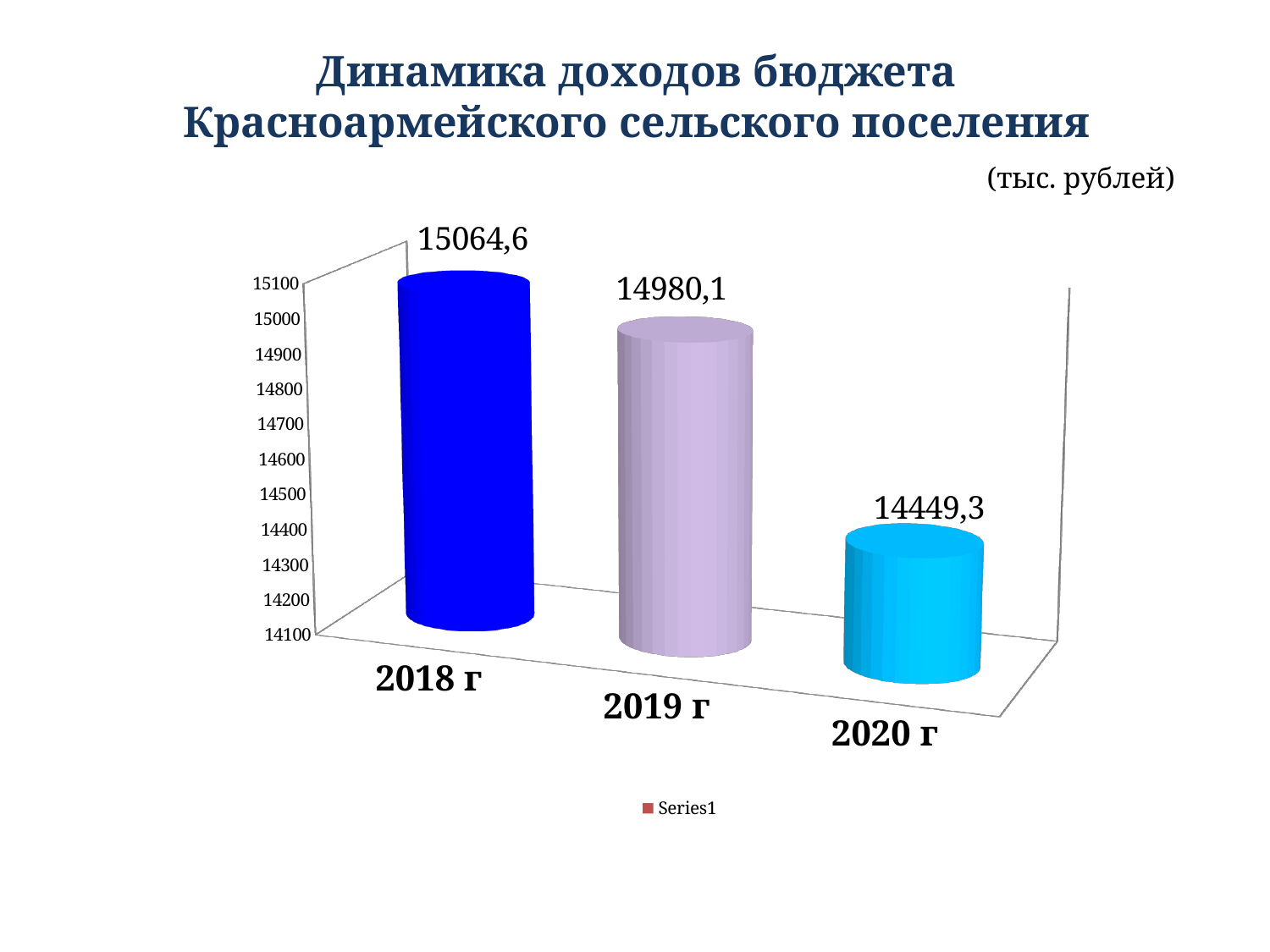
How many series does the legend list? 1 Which year has the highest value? 2018 г What is the value for 2018 г? 15064,6 What is the difference between the values for 2018 г and 2019 г? 84,5 What is the value for 2020 г? 14449,3 Do the values rise or fall from 2018 г to 2020 г? Fall What is the difference between the values for 2019 г and 2020 г? 530,8 How many categories are shown on the chart? 3 Which is larger, the value for 2019 г or the value for 2020 г? 2019 г Which year has the lowest value? 2020 г What kind of chart is shown on the slide? Bar chart What is the value for 2019 г? 14980,1